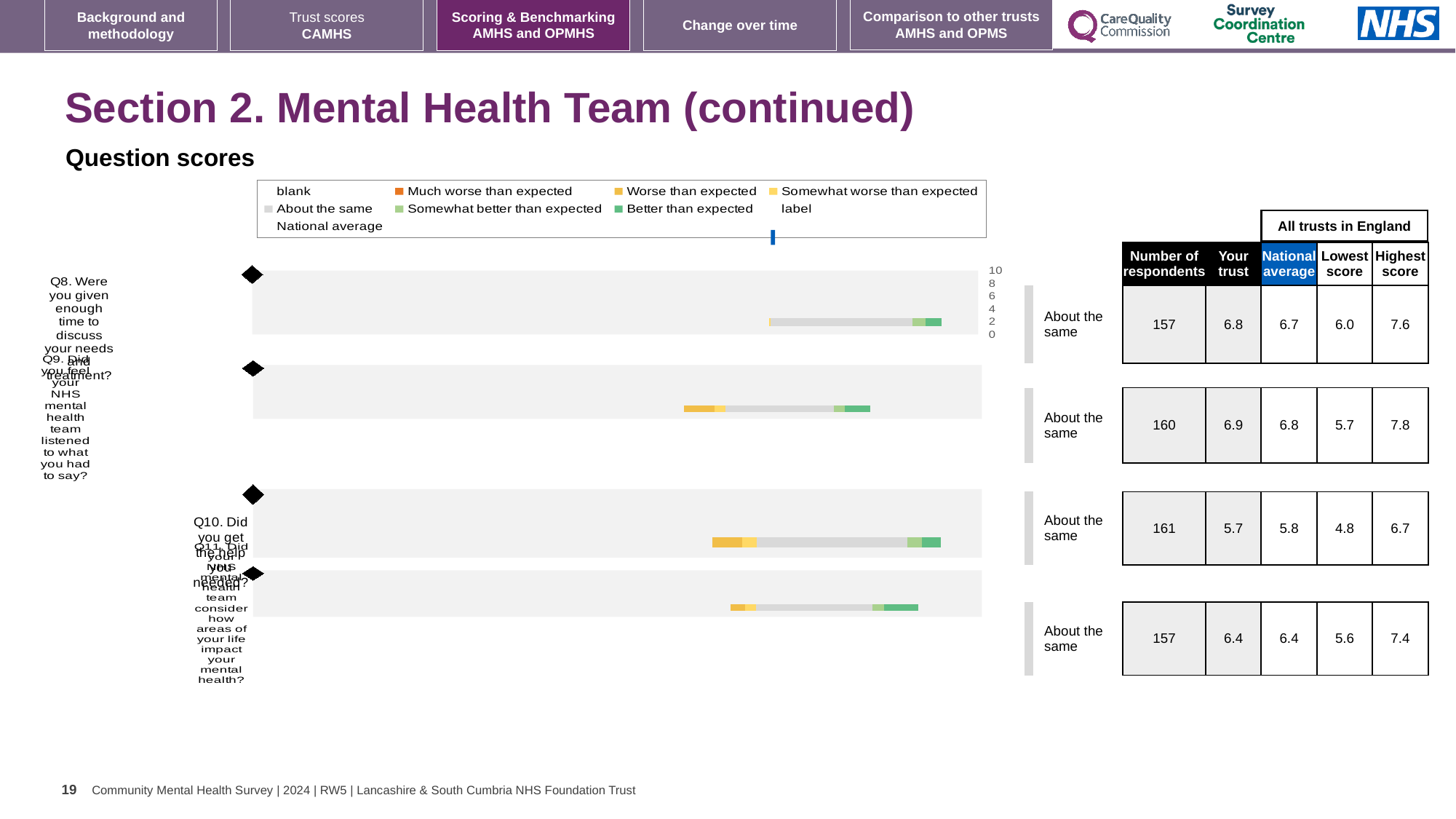
In the table beside the chart, how many respondents answered Q9? 160 What is the maximum value shown on the score axis of the question scores chart? 10 For Q9, what is the difference between the highest score and the lowest score among all trusts in England? 2.1 For Q8, which is larger: the 'Your trust' score or the national average? Your trust Which question has the highest 'Your trust' score in the table beside the chart? Q9 In the table beside the chart, what is the national average for Q10? 5.8 Which question has the lowest 'Your trust' score in the table beside the chart? Q10 In the table beside the chart, what is the highest score among all trusts in England for Q11? 7.4 What kind of chart is used to show the question scores on this slide? bar chart In the question scores chart legend, which colour represents 'Much worse than expected'? orange In the table beside the chart, what is the 'Your trust' score for Q8? 6.8 How many questions (bars) are plotted in the question scores chart? 4